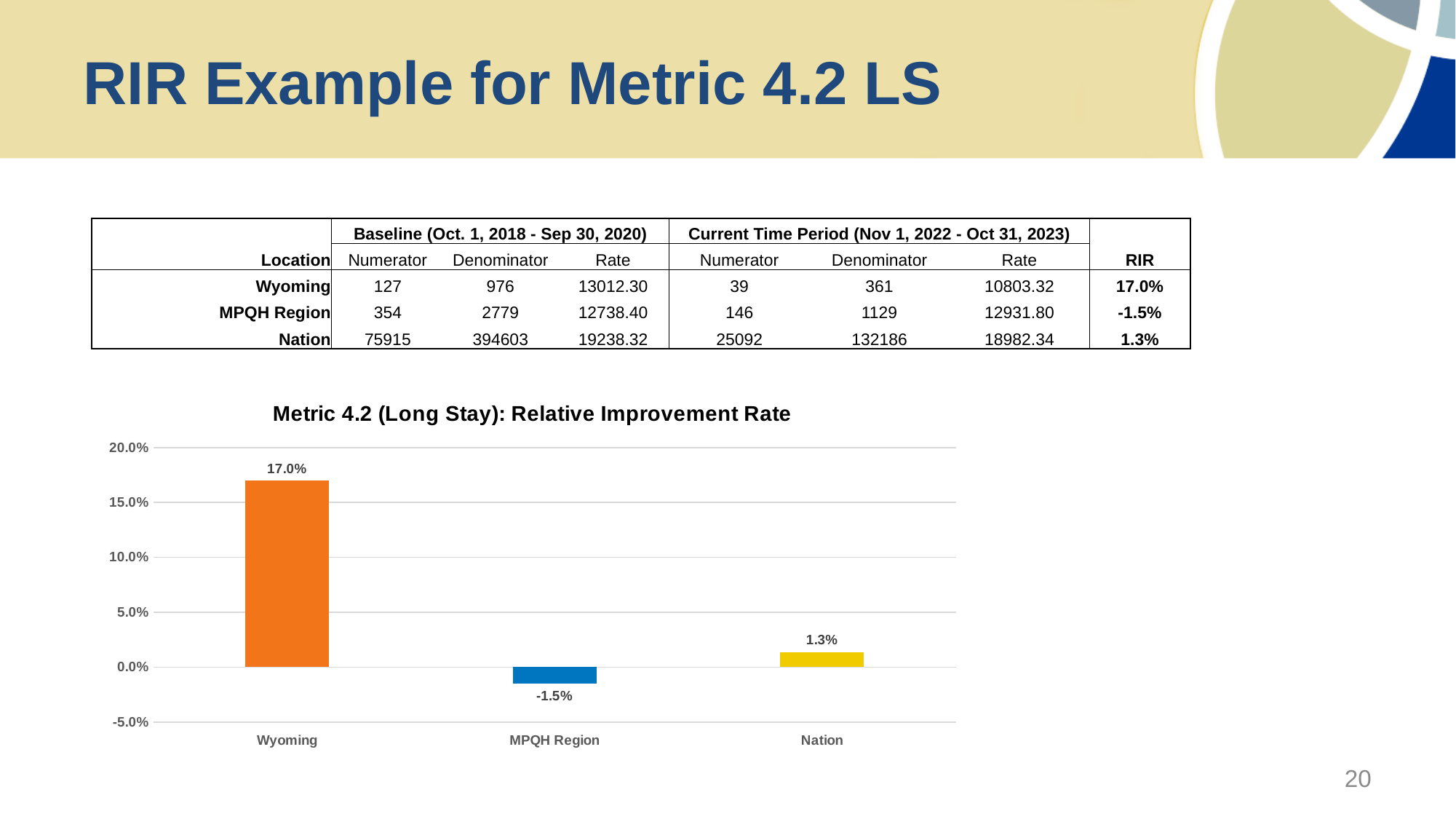
Which is larger, the value for Nation or the value for MPQH Region? Nation What colour is the bar for MPQH Region? blue What kind of chart is shown on the slide? bar chart What is the value for Nation in the chart? 1.3% Which category has the lowest value in the chart? MPQH Region Which category has the highest value in the chart? Wyoming What is the value for Wyoming in the chart? 17.0% How many categories are shown on the x axis of the chart? 3 What is the title of the chart? Metric 4.2 (Long Stay): Relative Improvement Rate What is the difference between the values for Wyoming and Nation? 15.7% What is the value for MPQH Region in the chart? -1.5% Is the value for Wyoming greater or less than 15.0%? greater